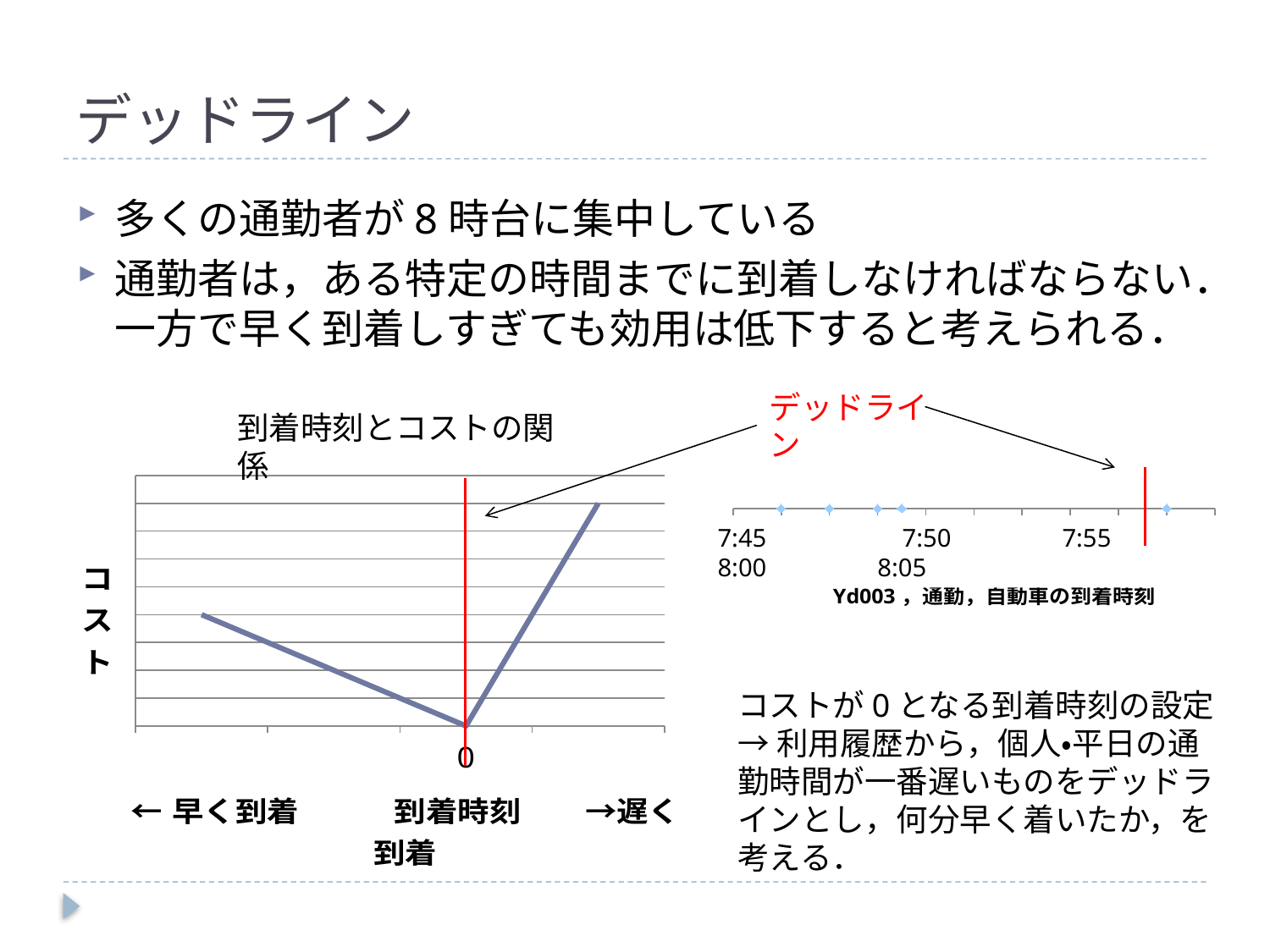
What kind of chart is the left chart titled 到着時刻とコストの関係? line chart In the right chart, are more of the plotted arrival times before or after the red deadline line? before In the left chart, what is the lowest value of the cost line, as printed on the slide? 0 In the left chart, which end of the line is higher: the far-left end or the far-right end? the far-right end In the right chart, is the red deadline line before or after 7:55? after What is the y-axis label of the left chart? コスト In the left chart, how does the cost change as arrival time moves to the right of the red deadline line? it rises In the right chart, what is the first time label on the axis? 7:45 In the left chart, how does the cost change as arrival time moves from the far left toward the red deadline line? it falls What is the title of the right chart? Yd003，通勤，自動車の到着時刻 In the right chart, what is the last time label on the axis? 8:05 What is the title of the left chart? 到着時刻とコストの関係